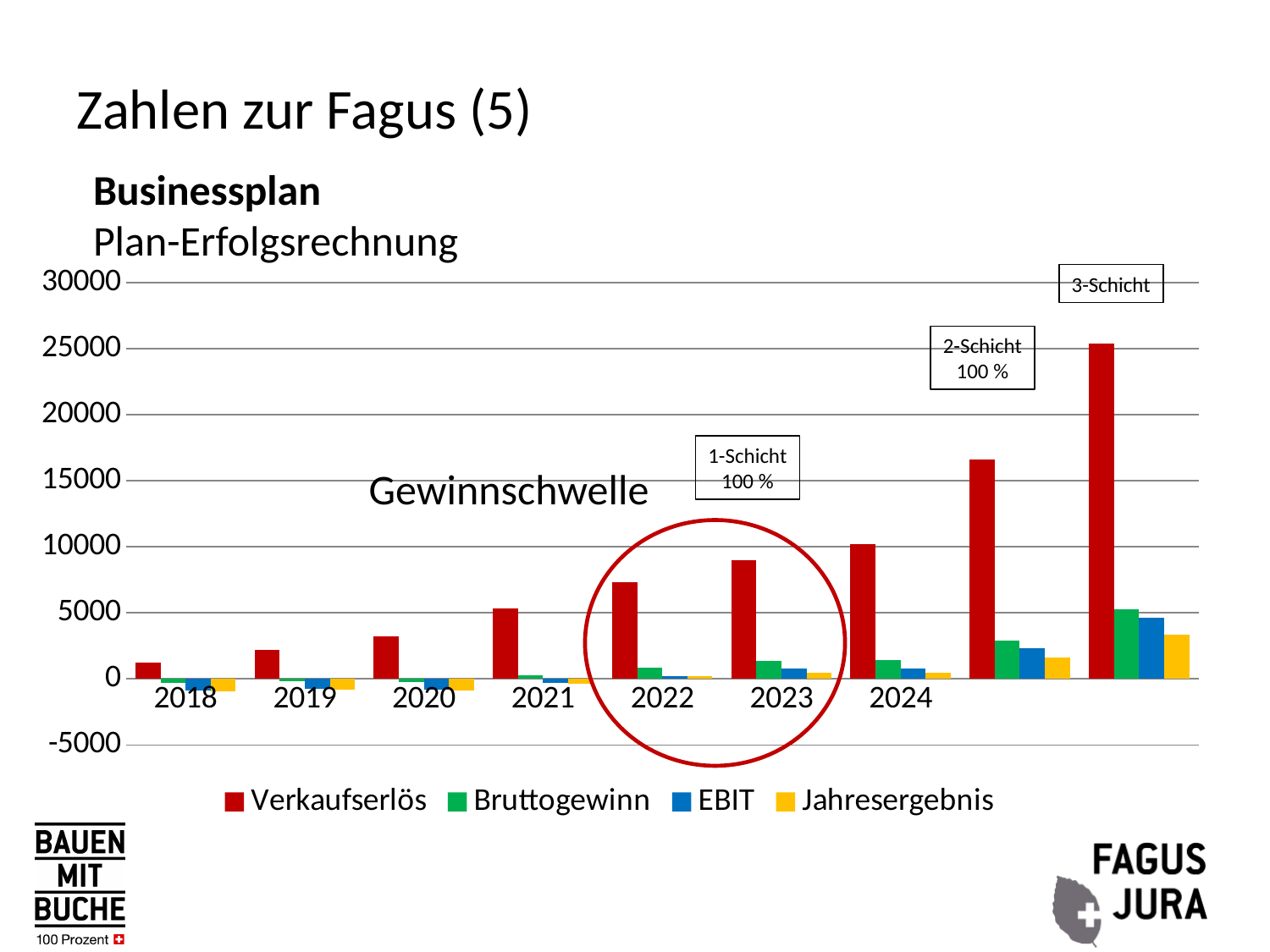
Is the Jahresergebnis value for 2018 greater or less than 0? less Among the labeled years, which year has the highest Verkaufserlös? 2024 Does Verkaufserlös rise or fall from 2018 to 2024? rise Which series are listed in the chart legend? Verkaufserlös, Bruttogewinn, EBIT, Jahresergebnis Is the Verkaufserlös value for 2023 greater or less than 10000? less Which is larger, the Verkaufserlös for 2022 or for 2023? 2023 How many year labels appear on the x axis? 7 Among the labeled years, which year has the lowest Verkaufserlös? 2018 How many series does the legend list? 4 Is the Verkaufserlös value for 2022 greater or less than 5000? greater What kind of chart is shown on the slide? bar chart What colour are the Verkaufserlös bars? red